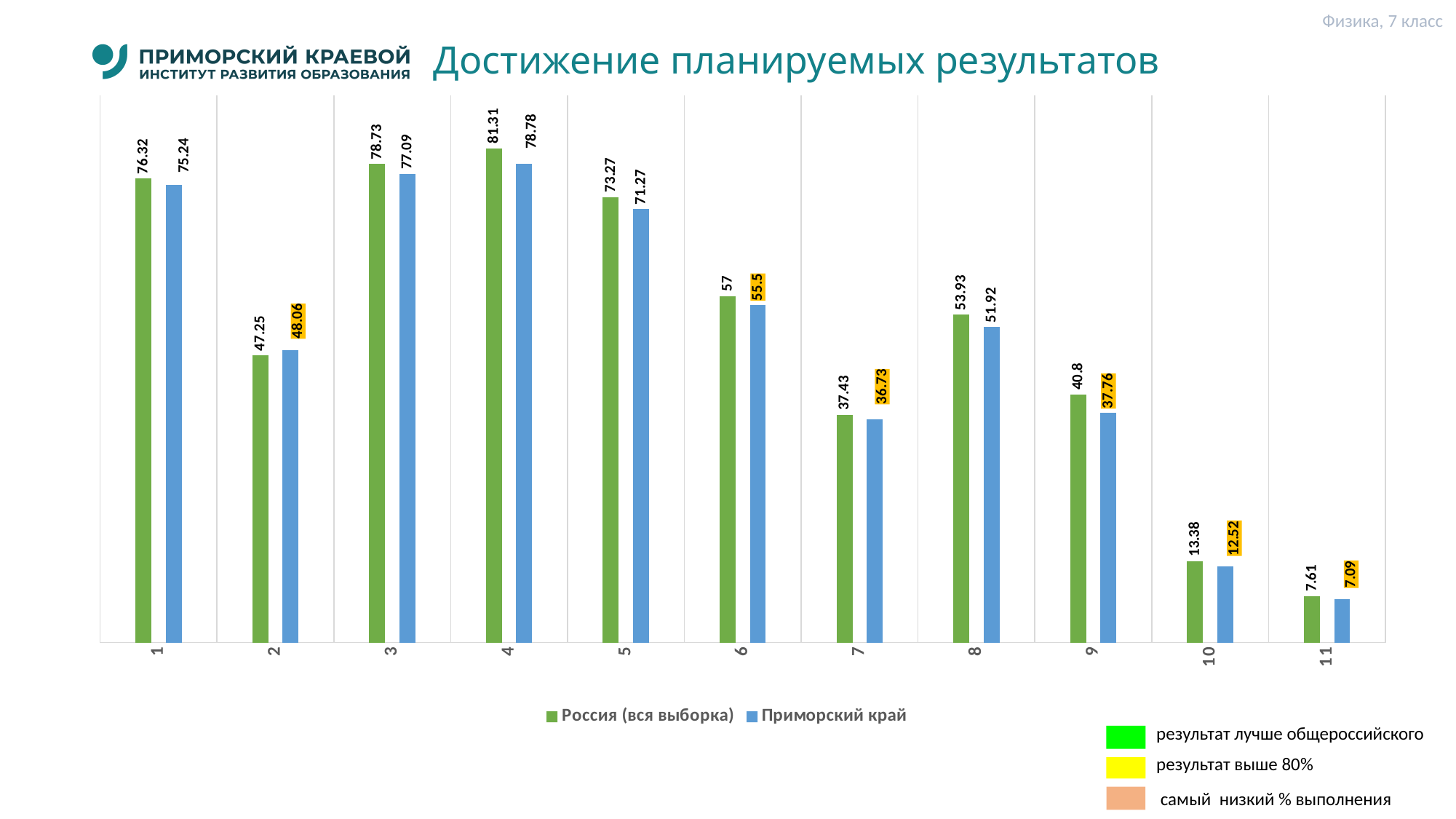
For category 2, which series has the larger value: Россия (вся выборка) or Приморский край? Приморский край Which category has the highest value for Приморский край? 4 How many series does the legend list? 2 What is the value for Россия (вся выборка) for category 6? 57 Which category has the lowest value for Россия (вся выборка)? 11 What is the value for Россия (вся выборка) for category 4? 81.31 What is the value for Приморский край for category 11? 7.09 What is the title of the chart? Достижение планируемых результатов What is the difference between the Россия (вся выборка) and Приморский край values for category 9? 3.04 What is the value for Приморский край for category 2? 48.06 How many categories are shown on the x axis? 11 What kind of chart is shown on the slide? Bar chart